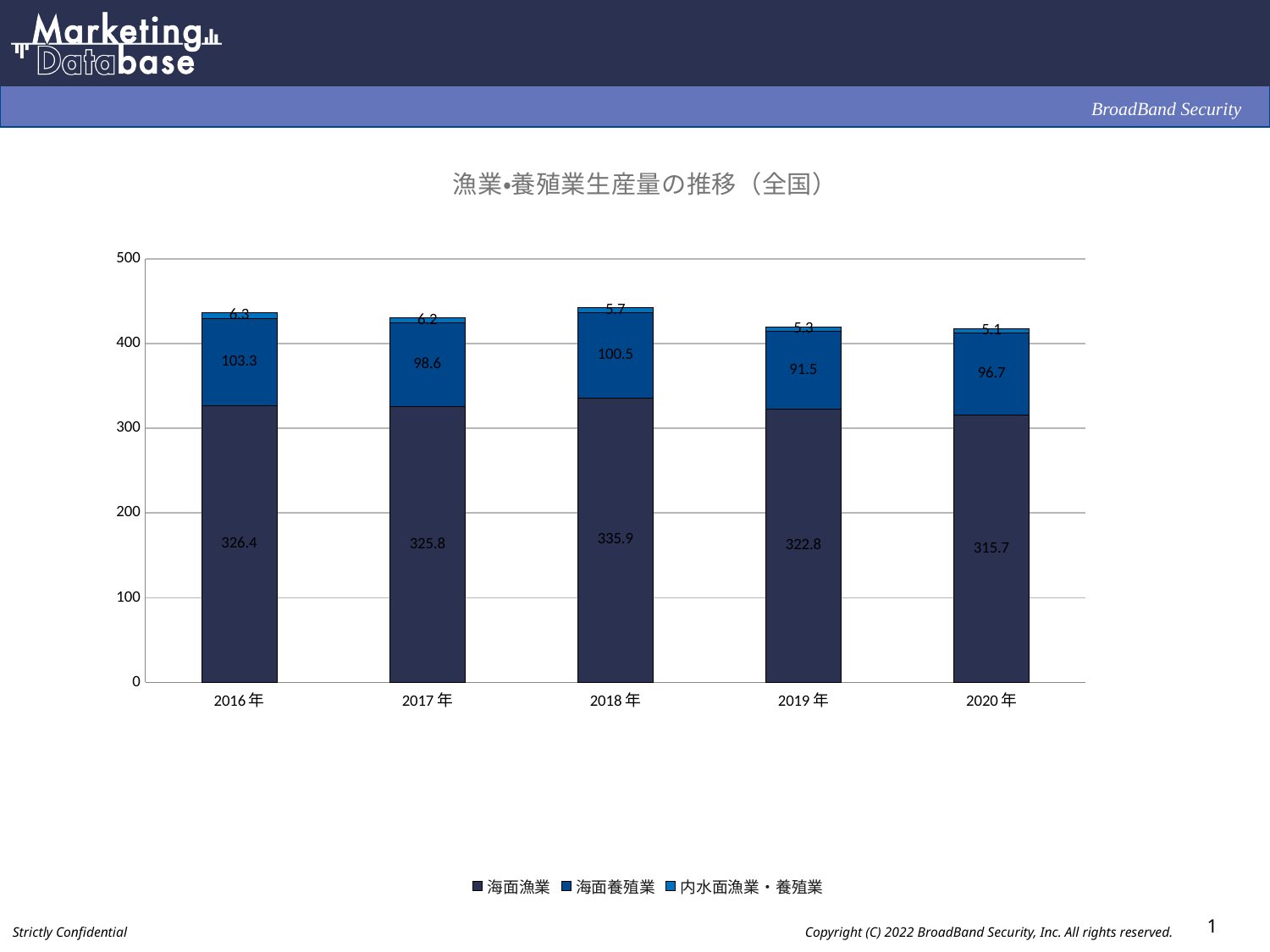
Which year has the lowest value for 海面養殖業? 2019年 What is the value of 海面漁業 for 2018年? 335.9 What is the total of the stacked bar for 2019年? 419.6 Which is larger, the 海面養殖業 value for 2017年 or for 2020年? 2017年 Does the value of 内水面漁業・養殖業 rise or fall from 2016年 to 2020年? Fall How many years are shown on the x axis? 5 What is the value of 海面養殖業 for 2019年? 91.5 Which year has the highest value for 海面漁業? 2018年 What is the value of 内水面漁業・養殖業 for 2016年? 6.3 What is the difference between the 海面漁業 values for 2016年 and 2020年? 10.7 How many series does the legend list? 3 What kind of chart is shown on the slide? Stacked bar chart